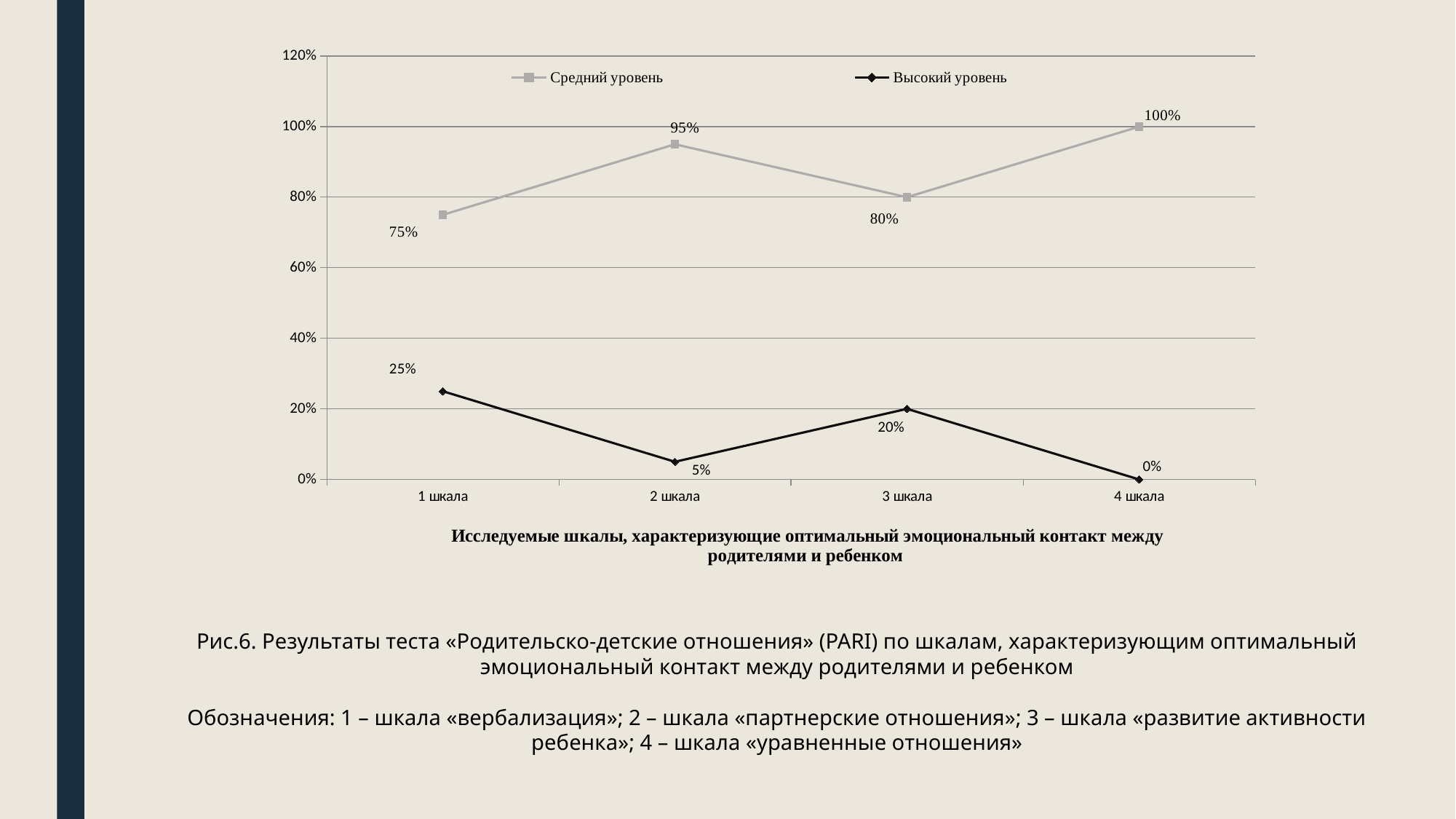
How many categories are shown on the x axis? 4 Does Высокий уровень rise or fall from 3 шкала to 4 шкала? fall What is the value of Высокий уровень for 3 шкала? 20% For which category is Средний уровень highest? 4 шкала What type of chart is shown on the slide? line chart What is the difference between Средний уровень and Высокий уровень for 1 шкала? 50% What are the two series named in the legend? Средний уровень and Высокий уровень What is the value of Средний уровень for 1 шкала? 75% How many series does the legend list? 2 What is the value of Средний уровень for 2 шкала? 95% For which category is Высокий уровень lowest? 4 шкала Which is larger for 2 шкала: Средний уровень or Высокий уровень? Средний уровень